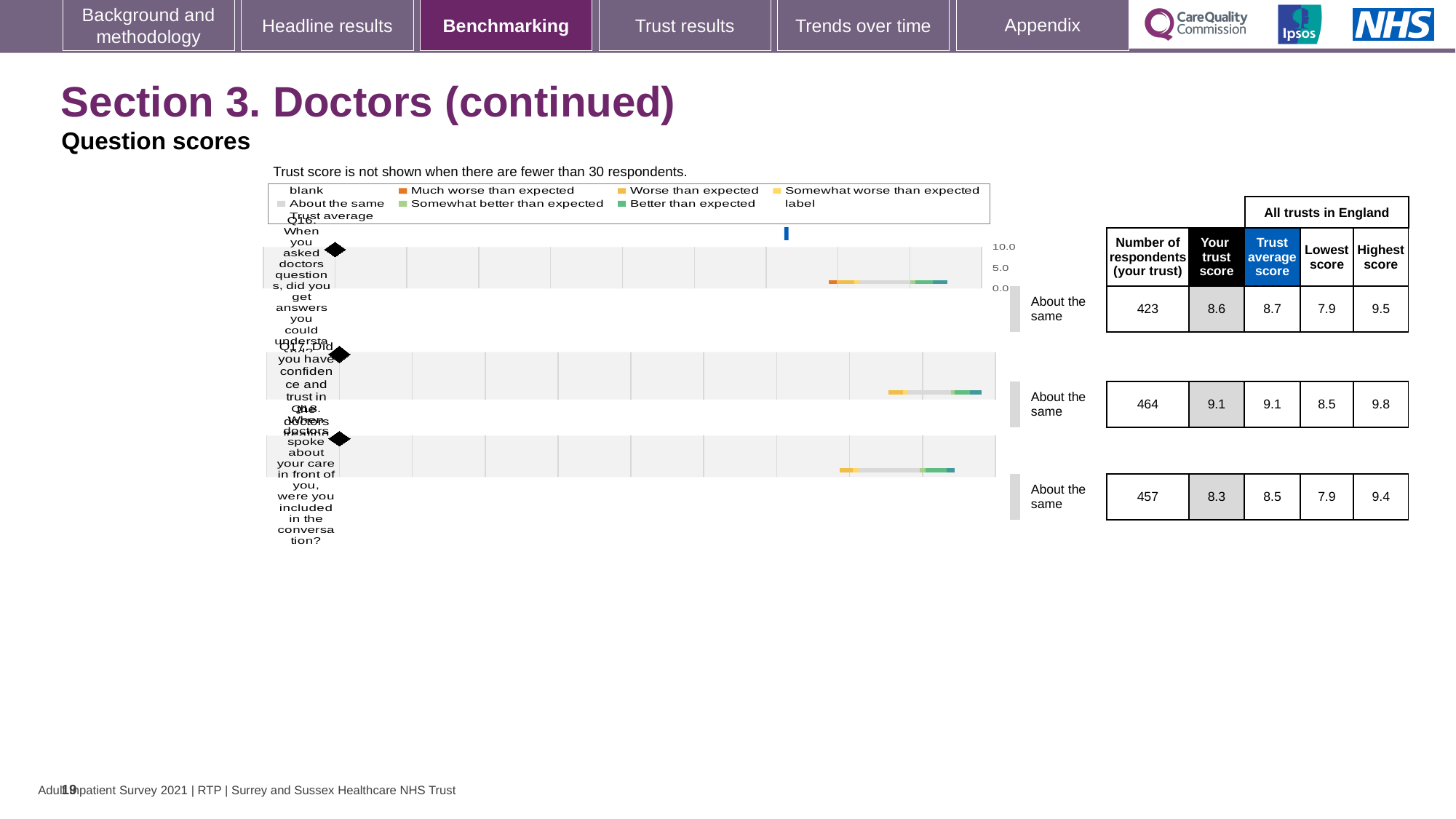
What is the 'Your trust score' for Q16 (When you asked doctors questions, did you get answers you could understand)? 8.6 What is the trust average score for Q17? 9.1 What benchmark category is shown for Q18? About the same What is the difference between the highest and lowest scores across all trusts in England for Q17? 1.3 Which is larger, your trust score for Q16 or your trust score for Q18? Q16 Which of the three questions has the highest 'Your trust score'? Q17 How many questions are plotted in the question scores chart? 3 What is the highest score across all trusts in England for Q18 (When doctors spoke about your care in front of you, were you included in the conversation)? 9.4 What is the difference between the trust average score and your trust score for Q16? 0.1 How many respondents from your trust answered Q17 (Did you have confidence and trust in the doctors treating you)? 464 What type of chart is used to show the question scores for Q16, Q17 and Q18? bar chart Which of the three questions has the lowest 'Your trust score'? Q18